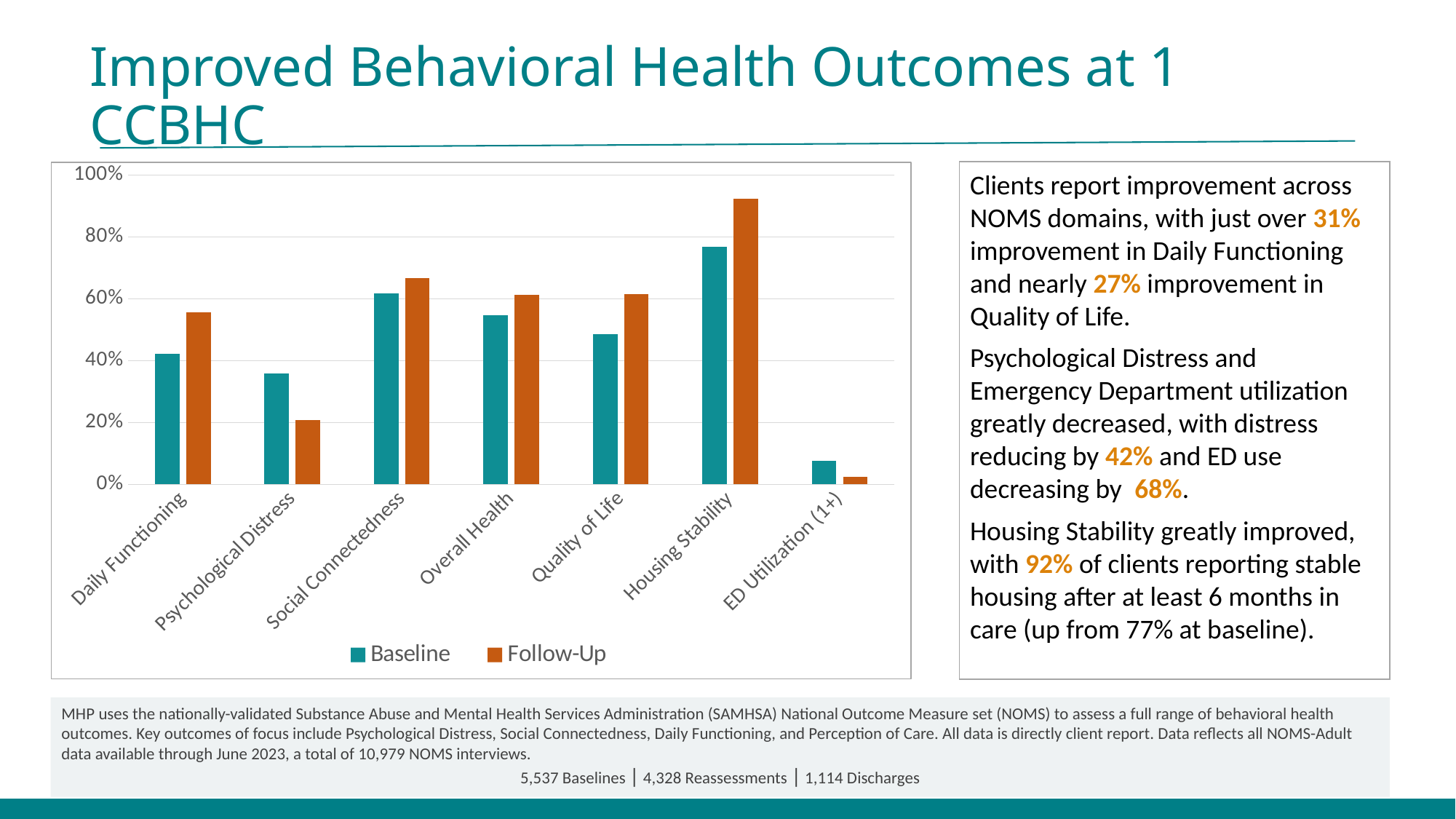
Is the Follow-Up value for Housing Stability greater or less than 80%? greater Is the Baseline value for ED Utilization (1+) greater or less than 20%? less What are the two series named in the chart legend? Baseline and Follow-Up Which category has the lowest Baseline value? ED Utilization (1+) How many series does the chart legend list? 2 How many categories are shown on the x axis of the chart? 7 For Psychological Distress, which is larger: the Baseline value or the Follow-Up value? Baseline For Daily Functioning, which is larger: the Baseline value or the Follow-Up value? Follow-Up Which category has the highest Follow-Up value? Housing Stability Is the Follow-Up value for Social Connectedness greater or less than 60%? greater What kind of chart is shown on the slide? bar chart